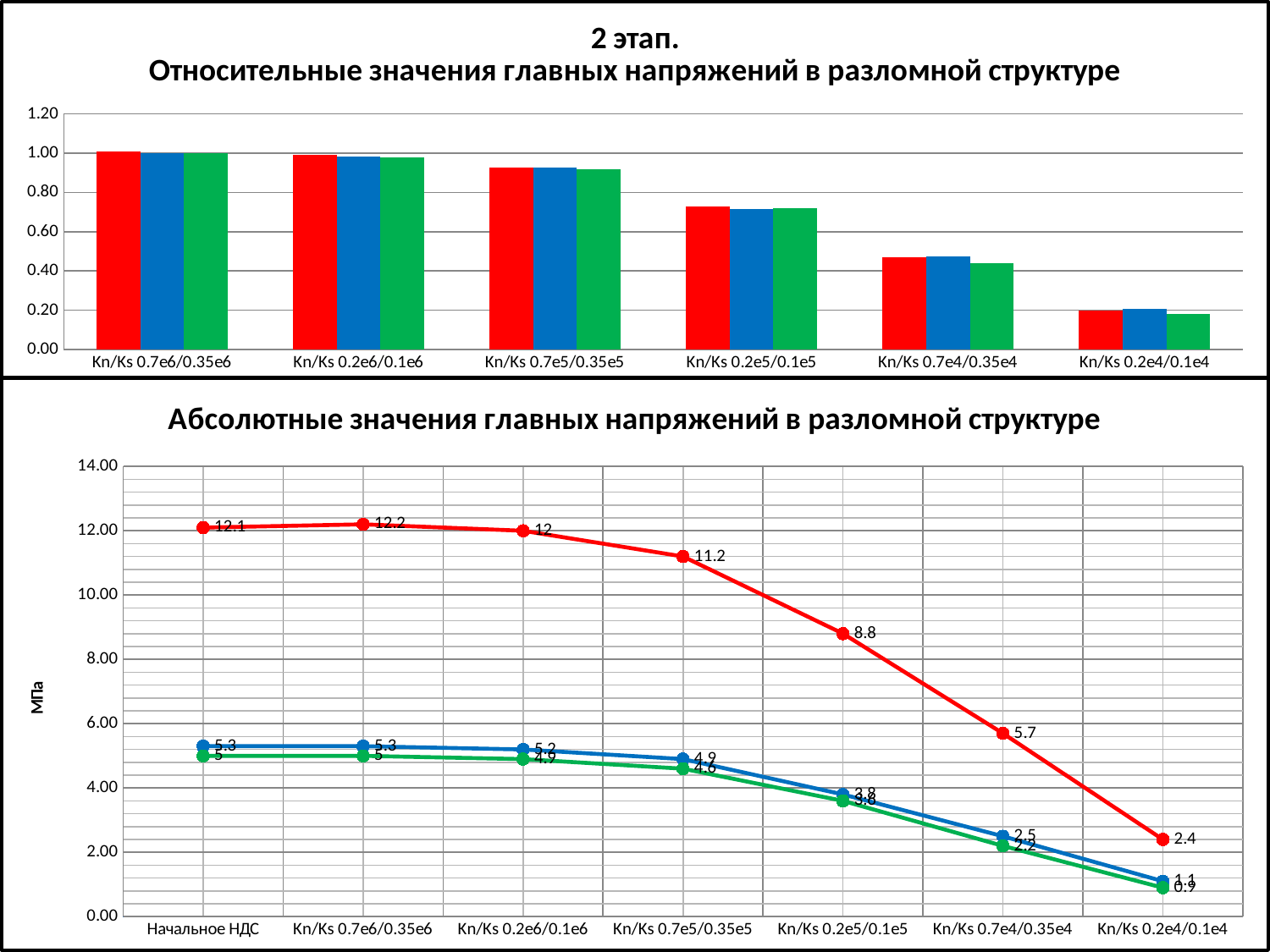
In the bottom line chart, does the red line rise or fall from Kn/Ks 0.7e5/0.35e5 to Kn/Ks 0.2e4/0.1e4? fall In the top bar chart, how many categories are shown on the x axis? 6 In the top bar chart, is the green bar for Kn/Ks 0.2e4/0.1e4 greater or less than 0.20? less In the bottom line chart, how many categories are shown on the x axis? 7 What kind of chart is the bottom chart titled "Абсолютные значения главных напряжений в разломной структуре"? line chart In the bottom line chart, at which category does the red line reach its highest value? Kn/Ks 0.7e6/0.35e6 In the top bar chart, is the red bar for Kn/Ks 0.2e5/0.1e5 greater or less than 0.60? greater In the bottom line chart, what is the value of the blue line at Kn/Ks 0.7e4/0.35e4? 2.5 What kind of chart is the top chart titled "Относительные значения главных напряжений в разломной структуре"? bar chart In the bottom line chart, what is the value of the red line at Kn/Ks 0.2e5/0.1e5? 8.8 In the bottom line chart, what is the difference between the red line values at Начальное НДС and Kn/Ks 0.2e4/0.1e4? 9.7 In the bottom line chart, what is the value of the green line at Kn/Ks 0.2e4/0.1e4? 0.9